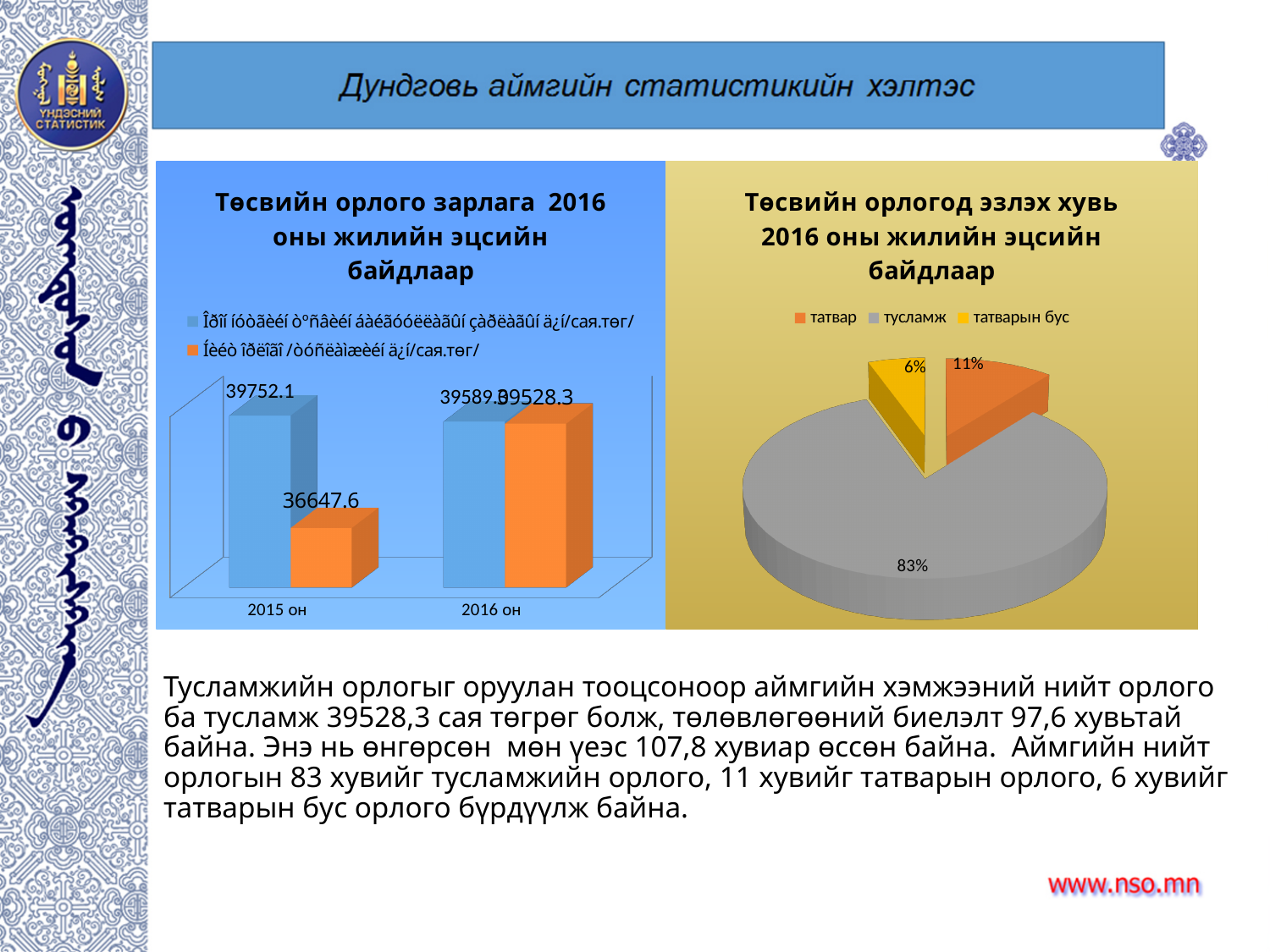
In the pie chart on the right, which category has the smallest slice? татварын бус In the bar chart on the left, what is the value of the orange bar for 2016 он? 39528.3 In the bar chart on the left, what is the difference between the blue bar and the orange bar for 2015 он? 3104.5 In the pie chart titled "Төсвийн орлогод эзлэх хувь 2016 оны жилийн эцсийн байдлаар", what share does тусламж have? 83% In the bar chart on the left, what is the value of the orange bar for 2015 он? 36647.6 In the pie chart on the right, how many slices are there? 3 In the pie chart on the right, what share does татварын бус have? 6% In the pie chart on the right, what share does татвар have? 11% In the pie chart on the right, how many percentage points larger is the тусламж slice than the татвар slice? 72% In the pie chart on the right, which category has the largest slice? тусламж In the bar chart on the left, how many categories are shown on the x axis? 2 In the bar chart titled "Төсвийн орлого зарлага 2016 оны жилийн эцсийн байдлаар", what is the value of the blue bar for 2015 он? 39752.1